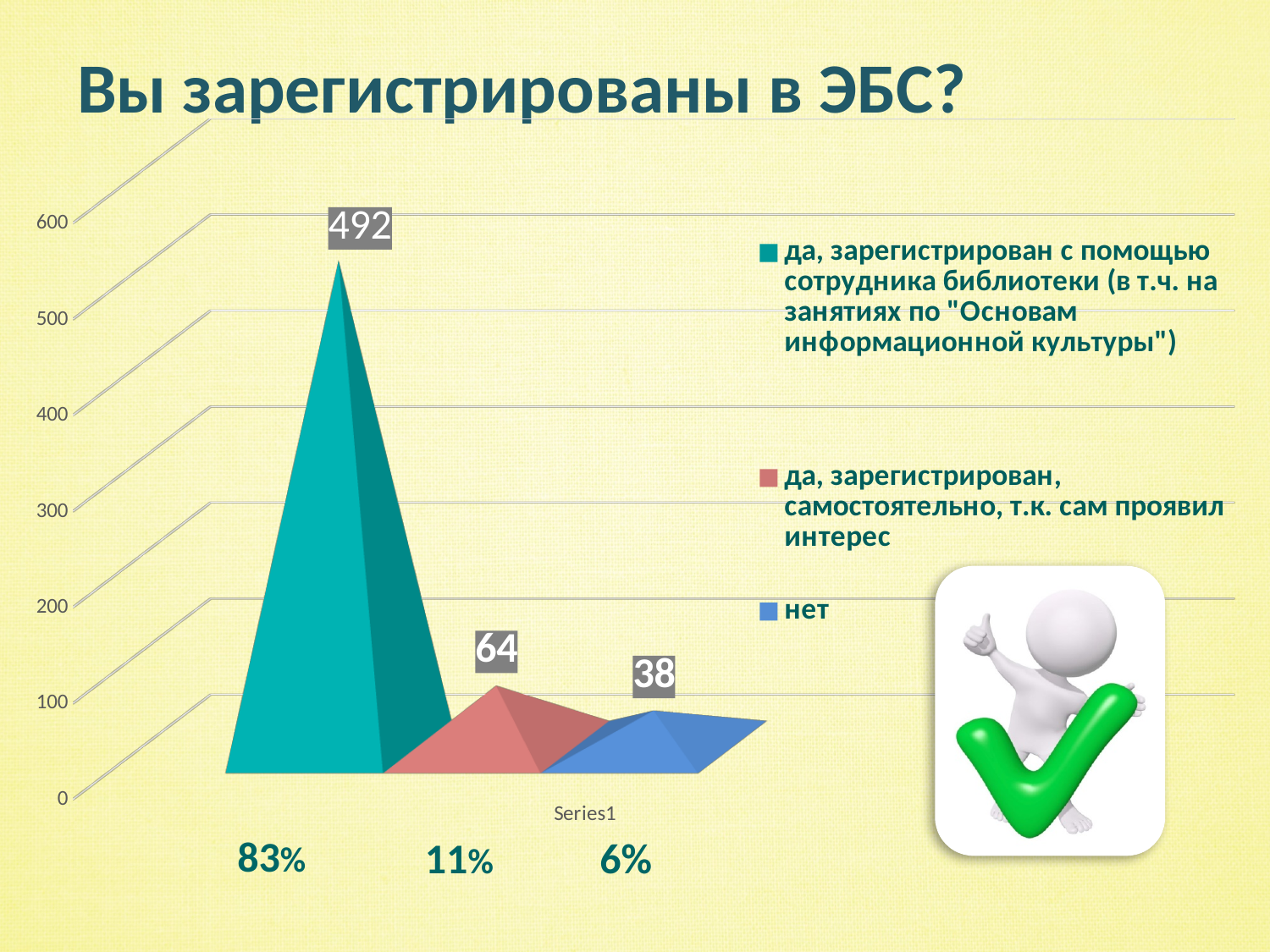
Which category has the highest value? да, зарегистрирован с помощью сотрудника библиотеки (в т.ч. на занятиях по "Основам информационной культуры") Which category has the lowest value? нет What is the difference between the value for "да, зарегистрирован, самостоятельно" and the value for "нет"? 26 What is the value for the category "нет"? 38 What kind of chart is shown on the slide? bar chart Which is larger: the value for "да, зарегистрирован, самостоятельно" or the value for "нет"? да, зарегистрирован, самостоятельно How many categories are plotted in the chart? 3 What is the value for "да, зарегистрирован, самостоятельно, т.к. сам проявил интерес"? 64 What is the title of the slide? Вы зарегистрированы в ЭБС? What is the value for "да, зарегистрирован с помощью сотрудника библиотеки"? 492 What is the difference between the highest value and the value for "нет"? 454 How many entries does the legend list? 3